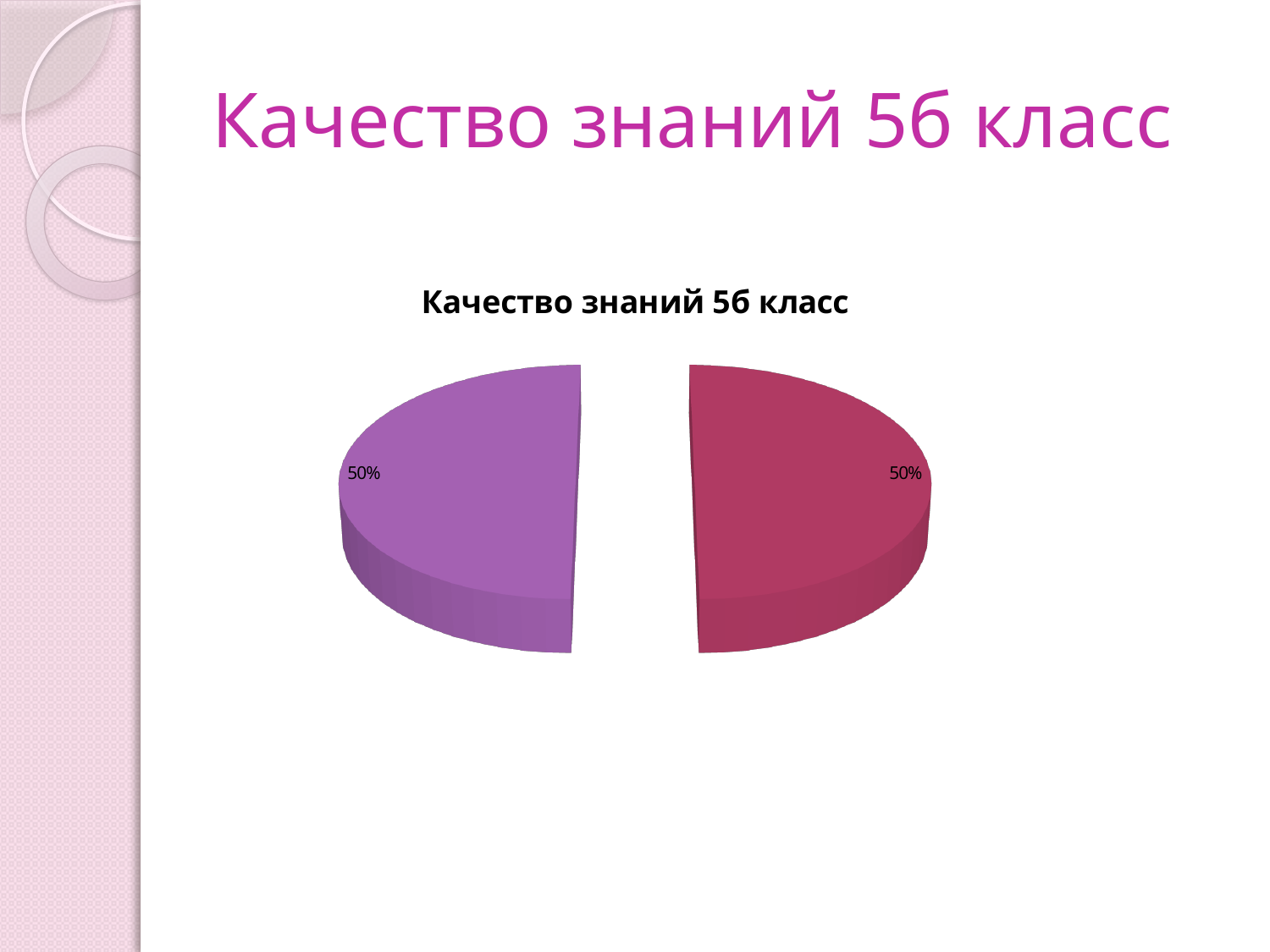
Is the share of the red slice greater or less than 25%? greater What share of the pie does the red slice on the right represent? 50% What is the difference between the share of the purple slice and the share of the red slice? 0% What is the title of the chart? Качество знаний 5б класс What kind of chart is shown on the slide? pie chart Does the chart have a legend? No Is the purple slice larger, smaller, or the same size as the red slice? the same size How many slices does the pie chart have? 2 What do the two slice percentages add up to? 100% What share of the pie does the purple slice on the left represent? 50%